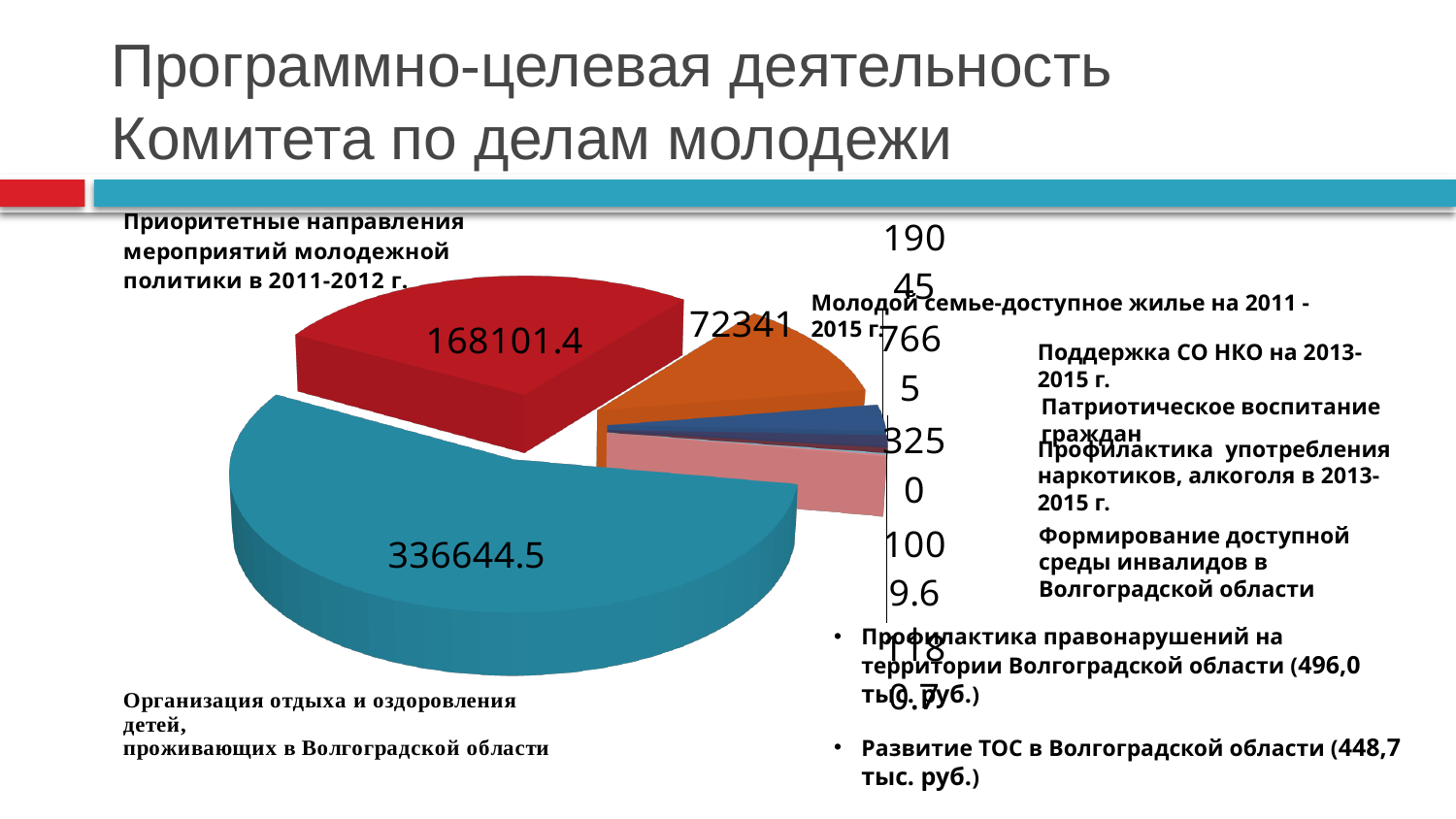
What is the value of the largest slice of the pie chart? 336644.5 What is the difference between the two largest slice values, 336644.5 and 168101.4? 168543.1 Which category has the largest slice of the pie chart? Организация отдыха и оздоровления детей, проживающих в Волгоградской области What is the difference between the slice values 168101.4 and 72341? 95760.4 What colour is the slice with value 168101.4? red Which slice is larger: the one labelled 168101.4 or the one labelled 72341? 168101.4 What value is shown for the slice labelled 'Молодой семье-доступное жилье на 2011-2015 г.'? 72341 What kind of chart is shown on the slide? pie chart What value is shown for the slice labelled 'Приоритетные направления мероприятий молодежной политики в 2011-2012 г.'? 168101.4 What value is shown for the slice labelled 'Организация отдыха и оздоровления детей, проживающих в Волгоградской области'? 336644.5 What colour is the largest slice of the pie chart? teal (blue-green)